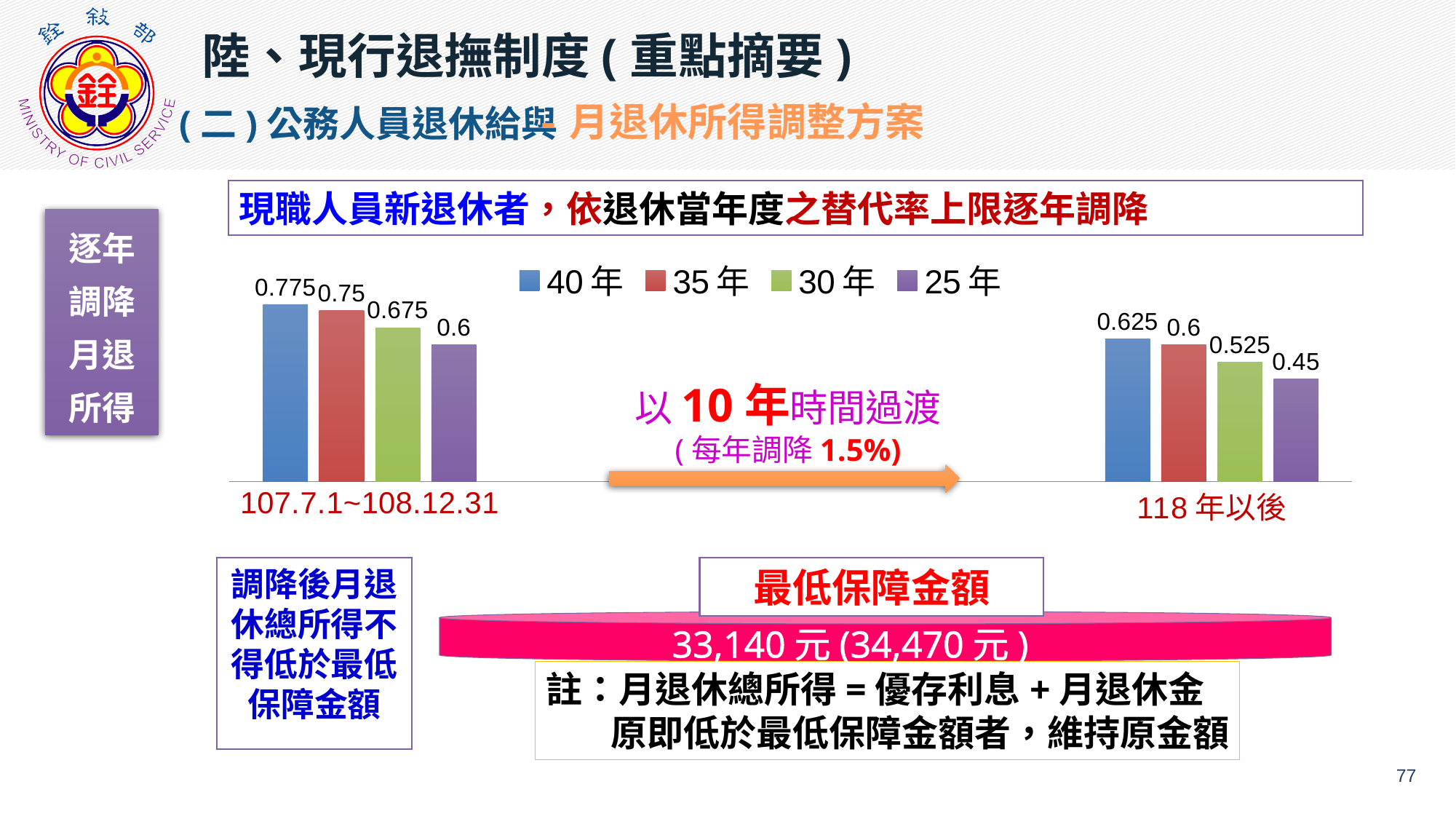
What is the value for the 40 年 series in the 107.7.1~108.12.31 category? 0.775 What is the difference between the 40 年 values for 107.7.1~108.12.31 and 118 年以後? 0.15 What kind of chart is shown on the slide? Bar chart Which series has the lowest value in the 107.7.1~108.12.31 category? 25 年 What is the difference between the 40 年 and 25 年 values in the 118 年以後 category? 0.175 Which series has the highest value in the 118 年以後 category? 40 年 What is the value for the 30 年 series in the 118 年以後 category? 0.525 How many series does the legend list? 4 How many categories are shown on the x axis? 2 Which is larger: the 25 年 value for 107.7.1~108.12.31 or the 35 年 value for 118 年以後? They are equal (0.6) What is the value for the 25 年 series in the 118 年以後 category? 0.45 What is the value for the 35 年 series in the 107.7.1~108.12.31 category? 0.75